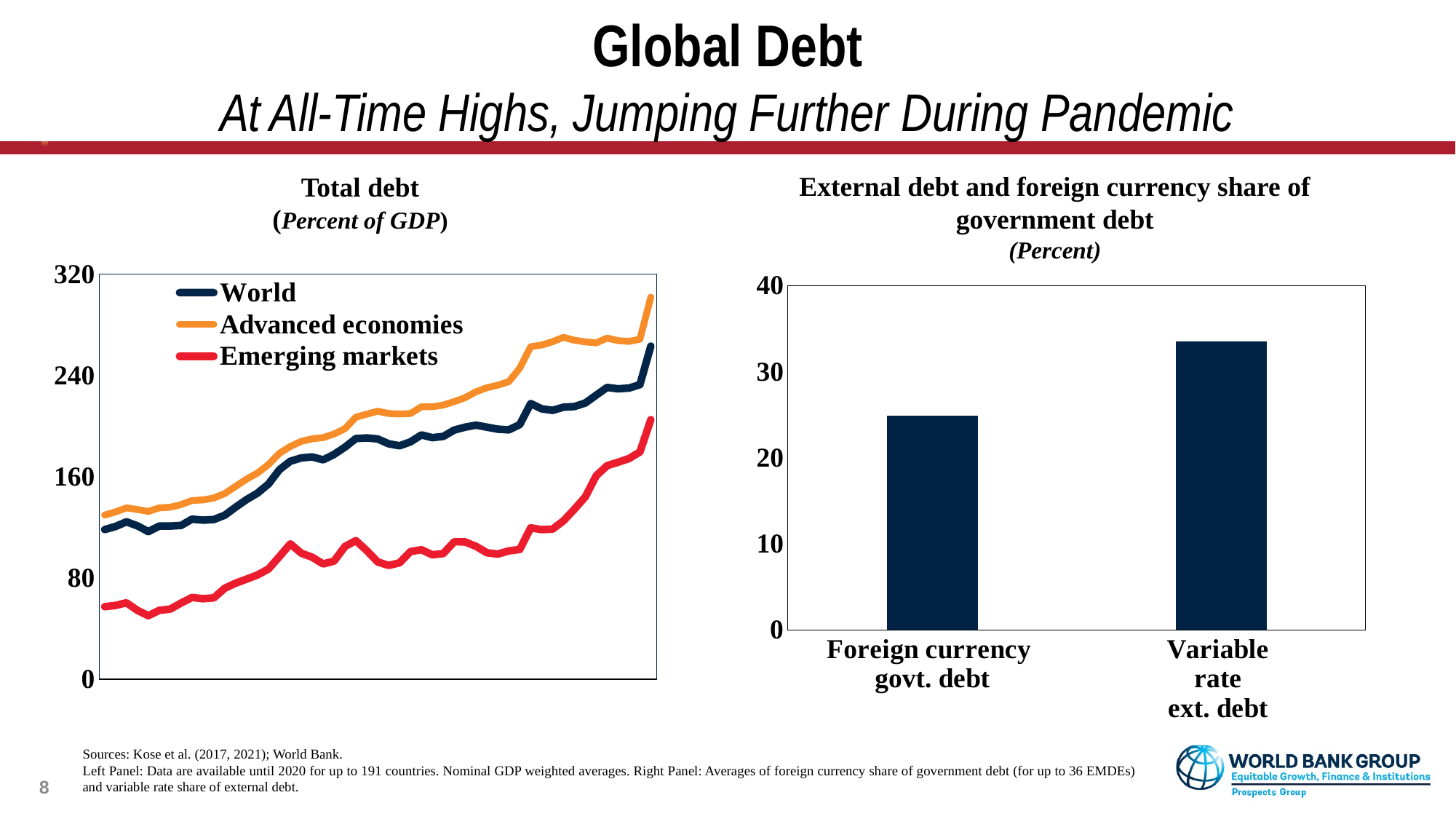
In the left chart "Total debt", which series has the highest values at the right end of the chart? Advanced economies In the right chart, is the value for Variable rate ext. debt greater or less than 30? greater In the left chart "Total debt", is the final value for Advanced economies greater or less than 240? greater In the left chart "Total debt", do the values for World generally rise or fall from left to right? rise In the left chart "Total debt", is the starting value for Emerging markets greater or less than 80? less What kind of chart is the right chart titled "External debt and foreign currency share of government debt"? bar chart What kind of chart is the left chart titled "Total debt"? line chart In the left chart "Total debt", which series has the lowest values throughout? Emerging markets In the left chart "Total debt", how many series does the legend list? 3 In the right chart, which category has the higher value: Foreign currency govt. debt or Variable rate ext. debt? Variable rate ext. debt In the right chart, how many bars are shown? 2